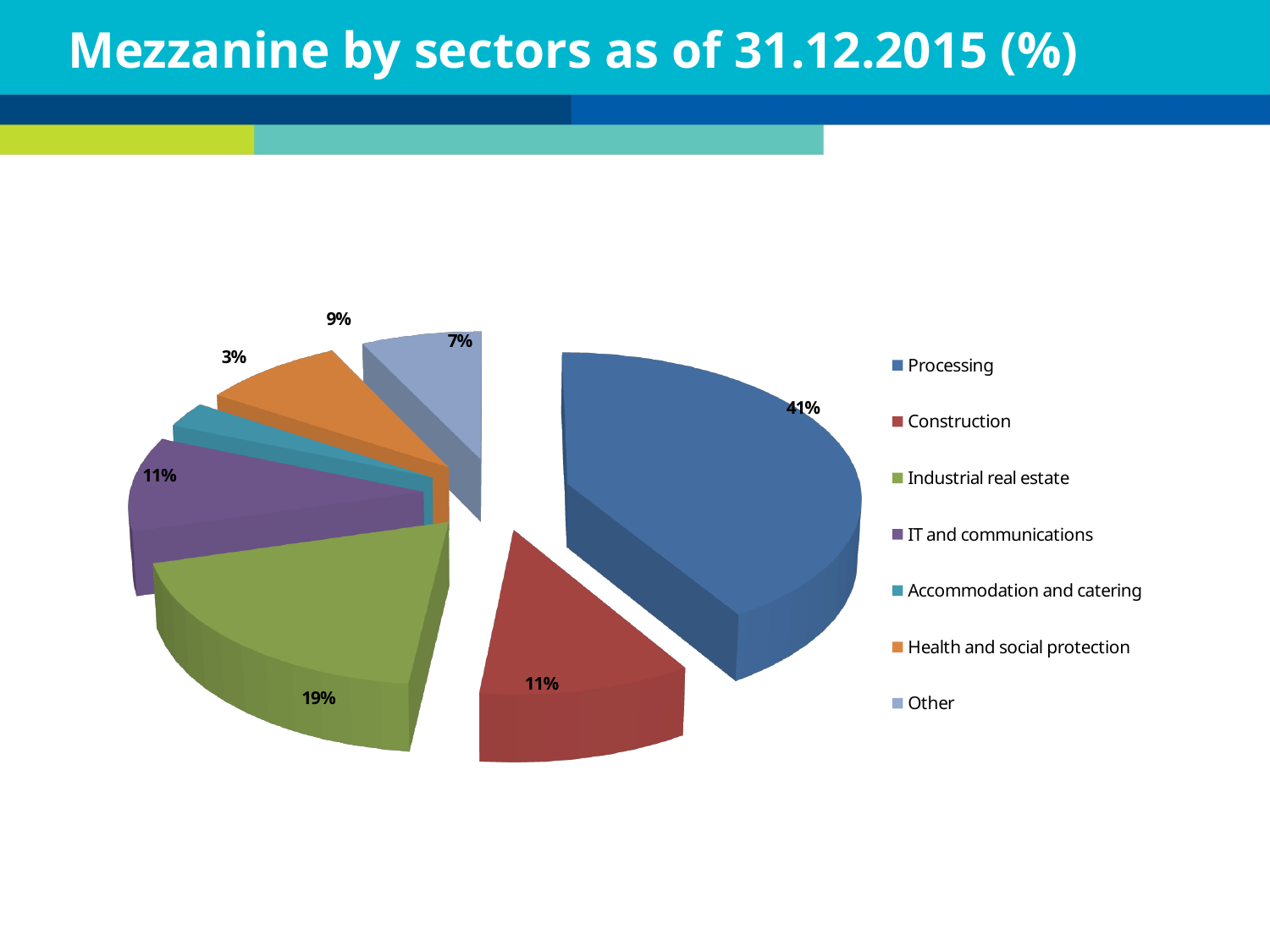
What is the value for Industrial real estate? 19% How many sectors are shown in the pie chart? 7 What share of mezzanine does Processing account for? 41% What is the value for Other? 7% What type of chart is shown on the slide? Pie chart Which is larger, the share for Health and social protection or the share for Other? Health and social protection What is the title of the chart? Mezzanine by sectors as of 31.12.2015 (%) What is the value for Health and social protection? 9% What is the value for Accommodation and catering? 3% What is the difference in percentage points between Processing and Industrial real estate? 22 Which sector has the smallest share of the pie? Accommodation and catering Which sector has the largest share of the pie? Processing